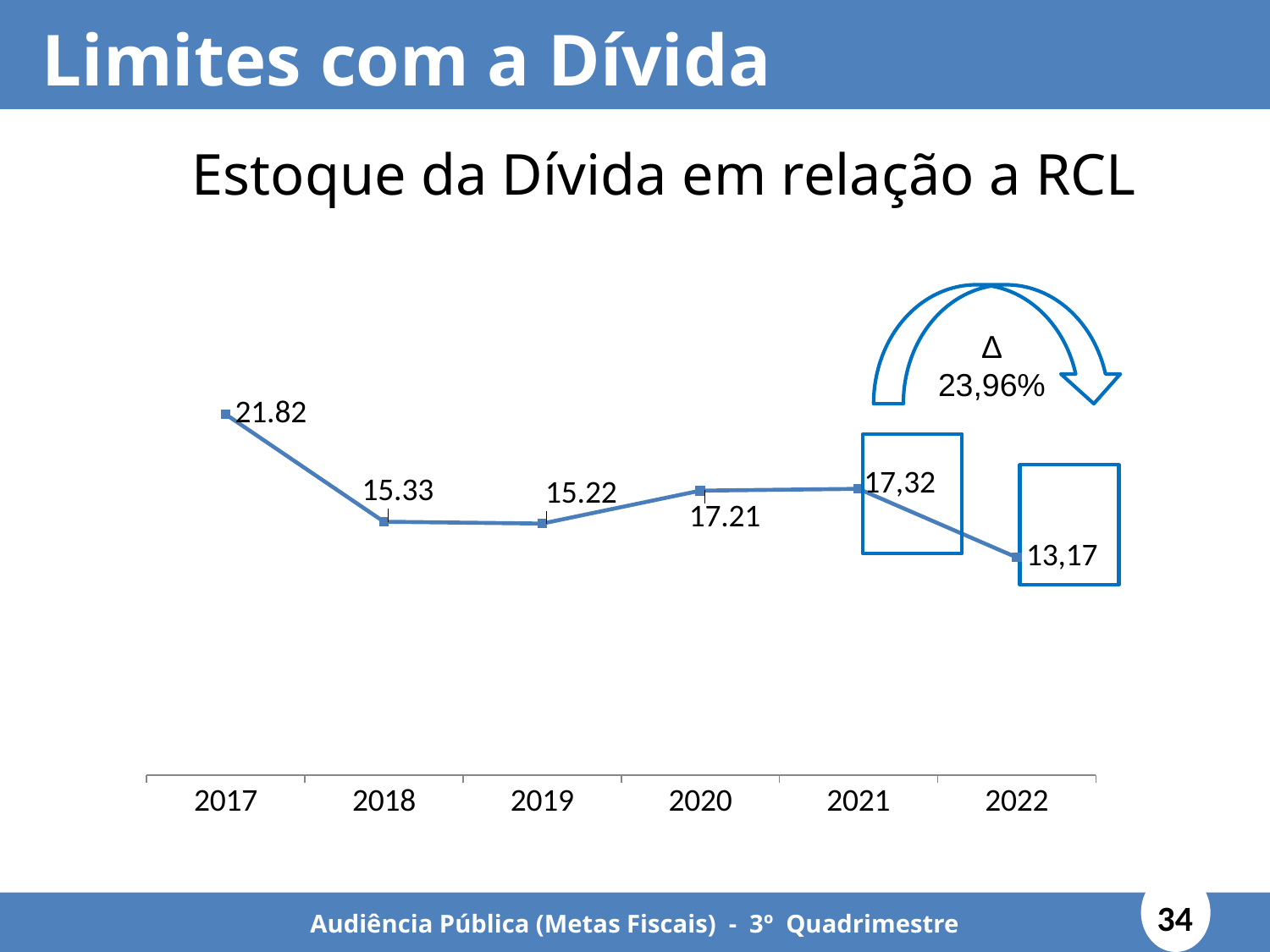
What is the value for 2020 in the chart? 17.21 What is the value for 2022 in the chart? 13,17 What is the difference between the values for 2021 and 2022? 4,15 How many years are plotted in the chart? 6 Which is larger, the value for 2018 or the value for 2019? 2018 What is the difference between the values for 2017 and 2018? 6.49 Does the value rise or fall from 2021 to 2022? Fall What is the title of the chart? Estoque da Dívida em relação a RCL What kind of chart is shown on the slide? Line chart Which year has the highest value in the chart? 2017 Which year has the lowest value in the chart? 2022 What is the value for 2017 in the chart? 21.82